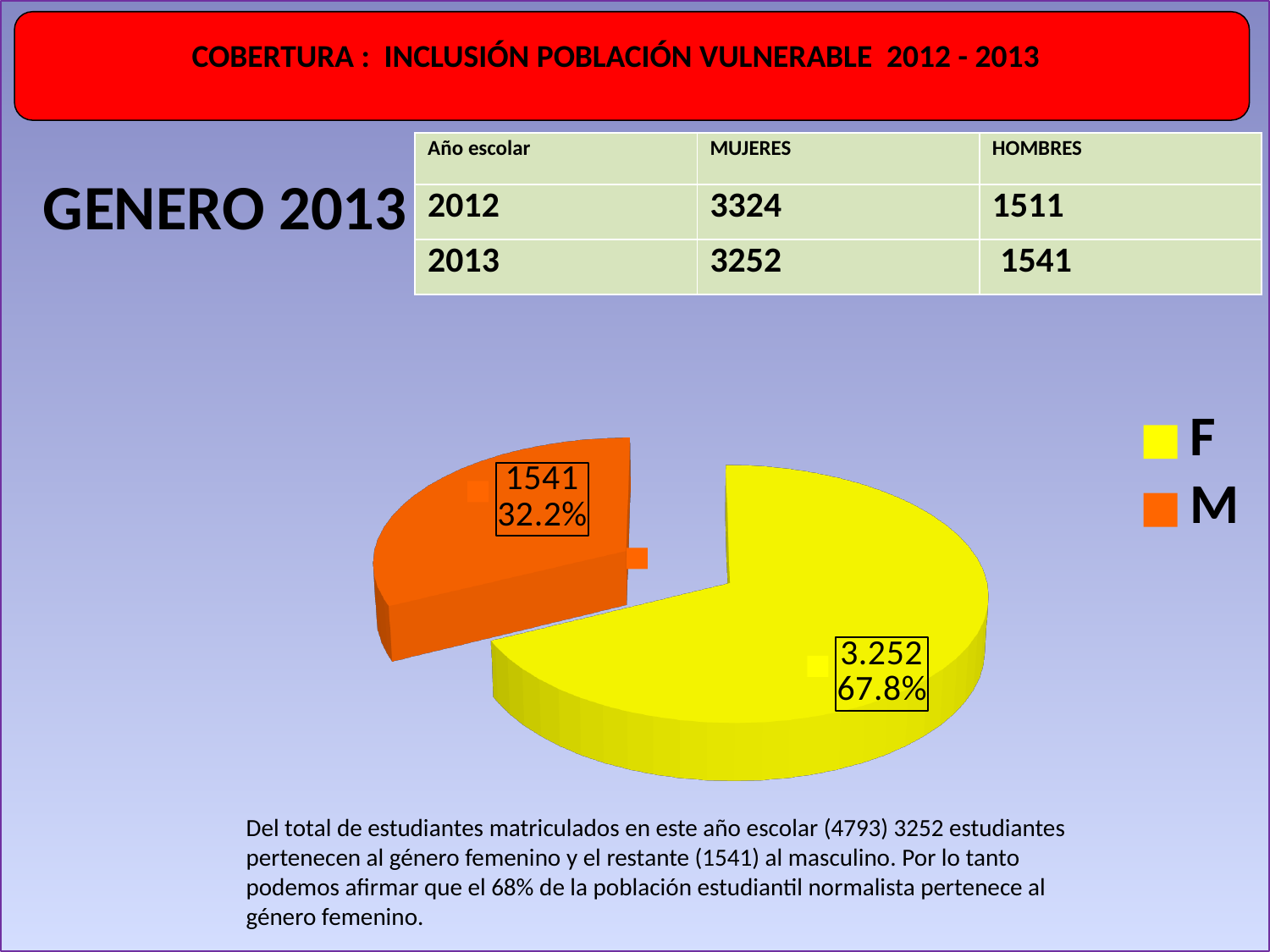
How many slices does the pie chart have? 2 Which slice of the pie chart is the largest? F Which slice of the pie chart is the smallest? M Which is larger in the pie chart, the F slice or the M slice? F What percentage share of the pie does the F slice represent? 67.8% What is the difference between the F value and the M value in the pie chart? 1711 What colour is the F slice in the pie chart? yellow How many entries does the pie chart legend list? 2 What value is shown for the M slice of the pie chart? 1541 What kind of chart is shown on the slide? pie chart What percentage share of the pie does the M slice represent? 32.2% What value is shown for the F slice of the pie chart? 3.252